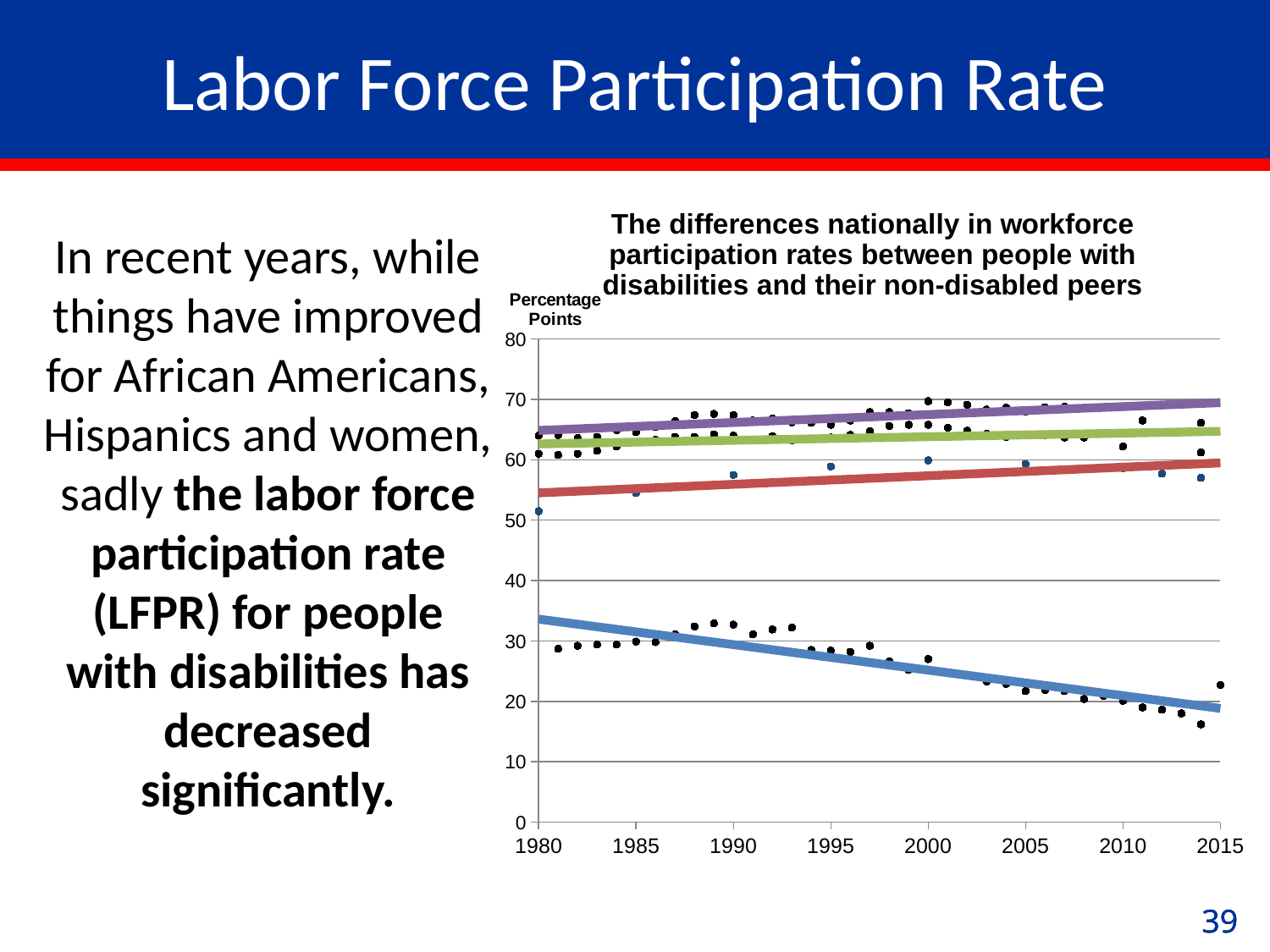
Is the value of the blue trend line at 1980 greater or less than 30? greater What is the title of the chart? The differences nationally in workforce participation rates between people with disabilities and their non-disabled peers Does the purple trend line rise or fall from 1980 to 2015? rise Is the value of the blue trend line at 2010 greater or less than 30? less What kind of chart is shown on the slide? scatter chart Which trend line is lowest on the chart, the blue one or the red one? the blue one What label is shown on the vertical axis of the chart? Percentage Points How many trend lines are drawn on the chart? 4 Does the red trend line rise or fall from 1980 to 2015? rise Is the value of the red trend line at 1980 greater or less than 60? less Does the blue trend line rise or fall from 1980 to 2015? fall